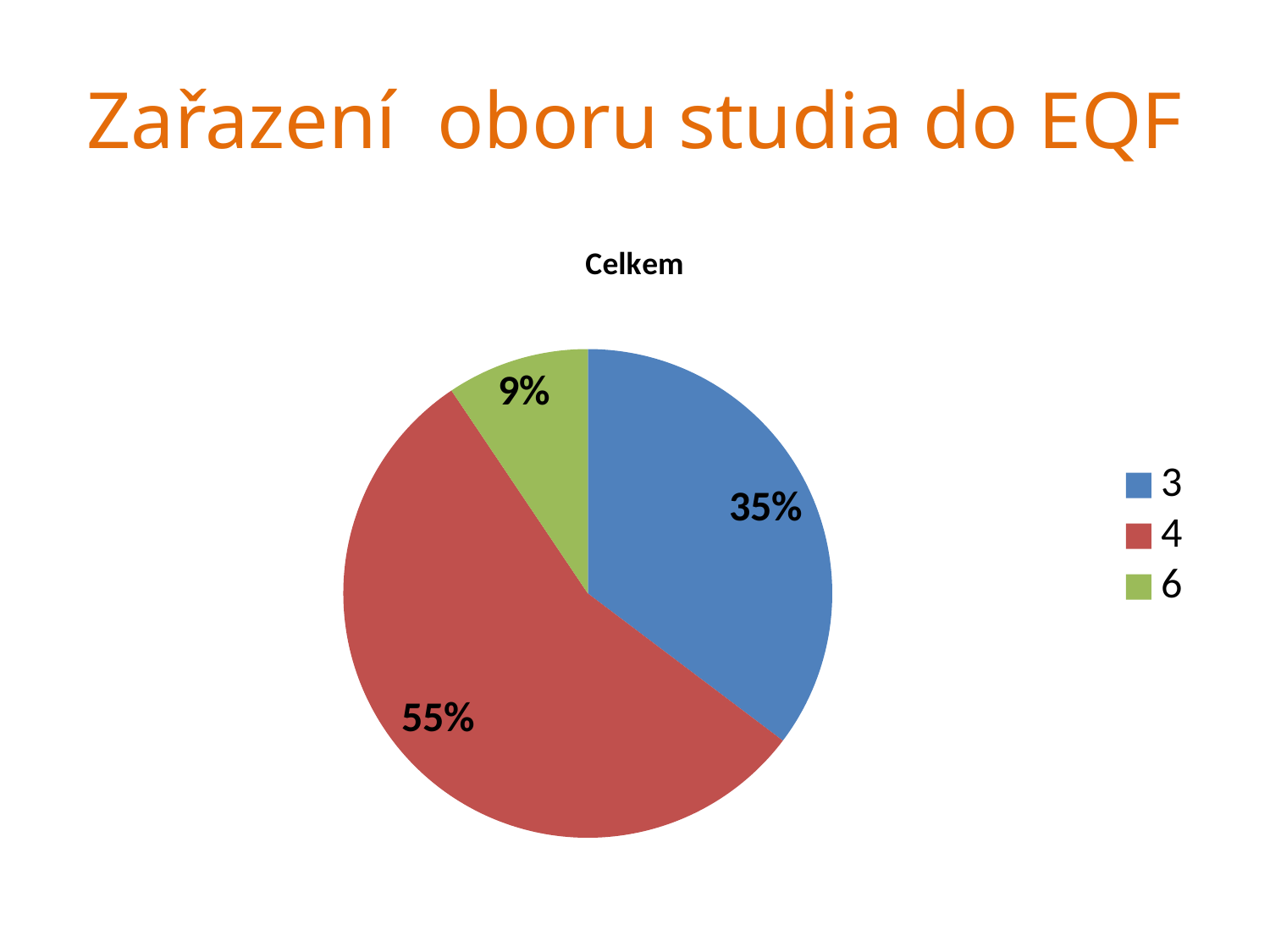
Which slice is larger, category 3 or category 6? 3 What is the chart's title? Celkem What is the difference in percentage points between the slices for category 4 and category 3? 20% How many slices does the pie chart have? 3 What kind of chart is shown on the slide? pie chart What share of the pie does category 6 have? 9% What share of the pie does category 4 have? 55% How many entries does the legend list? 3 What share of the pie does category 3 have? 35% Which category has the smallest slice of the pie? 6 What colour is the slice for category 6? green Which category has the largest slice of the pie? 4